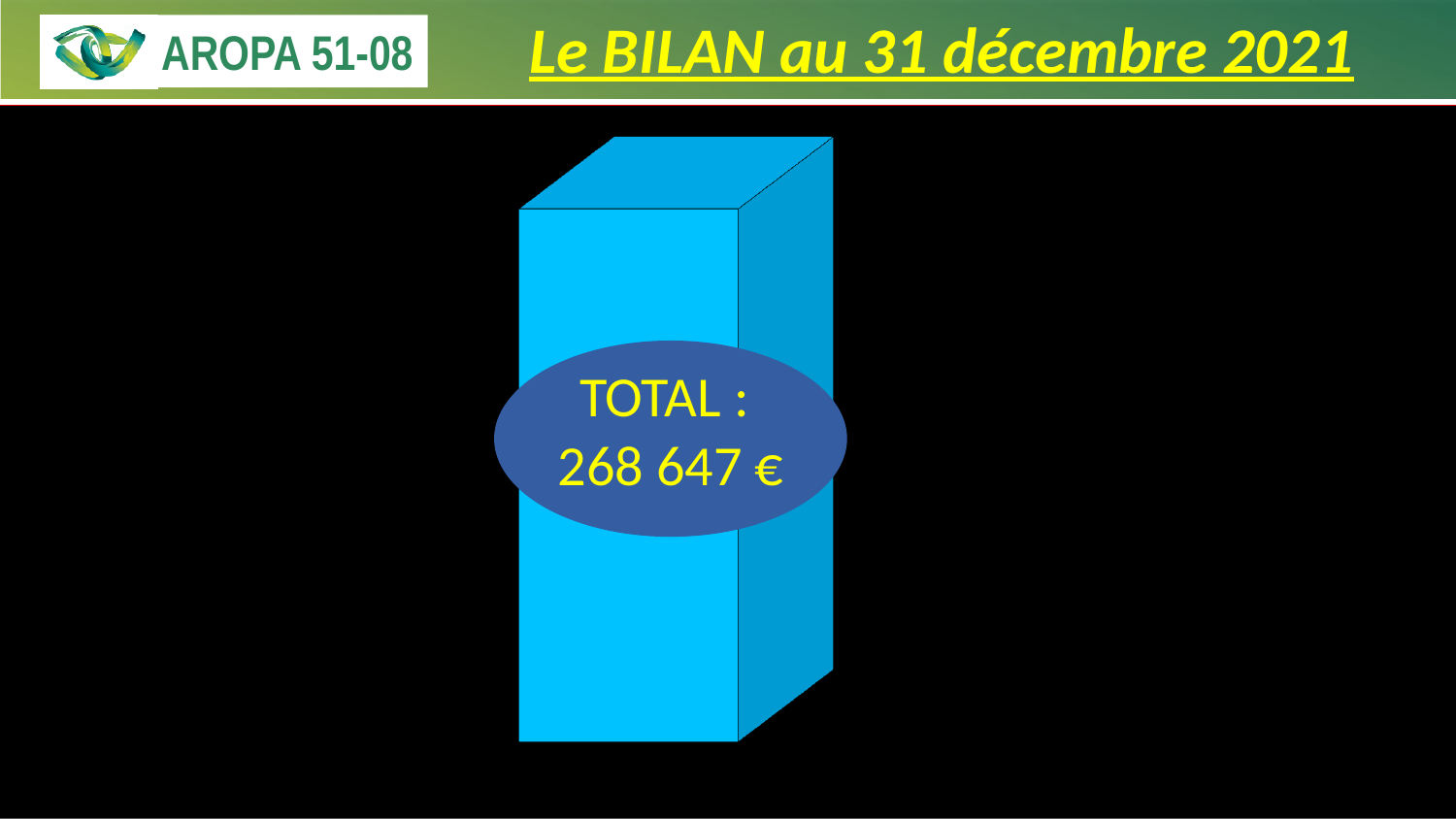
What kind of chart is shown on the slide? bar chart What total value is printed on the bar? 268 647 € How many bars are plotted on the chart? 1 What colour is the bar on the chart? blue What is the title of the slide containing the chart? Le BILAN au 31 décembre 2021